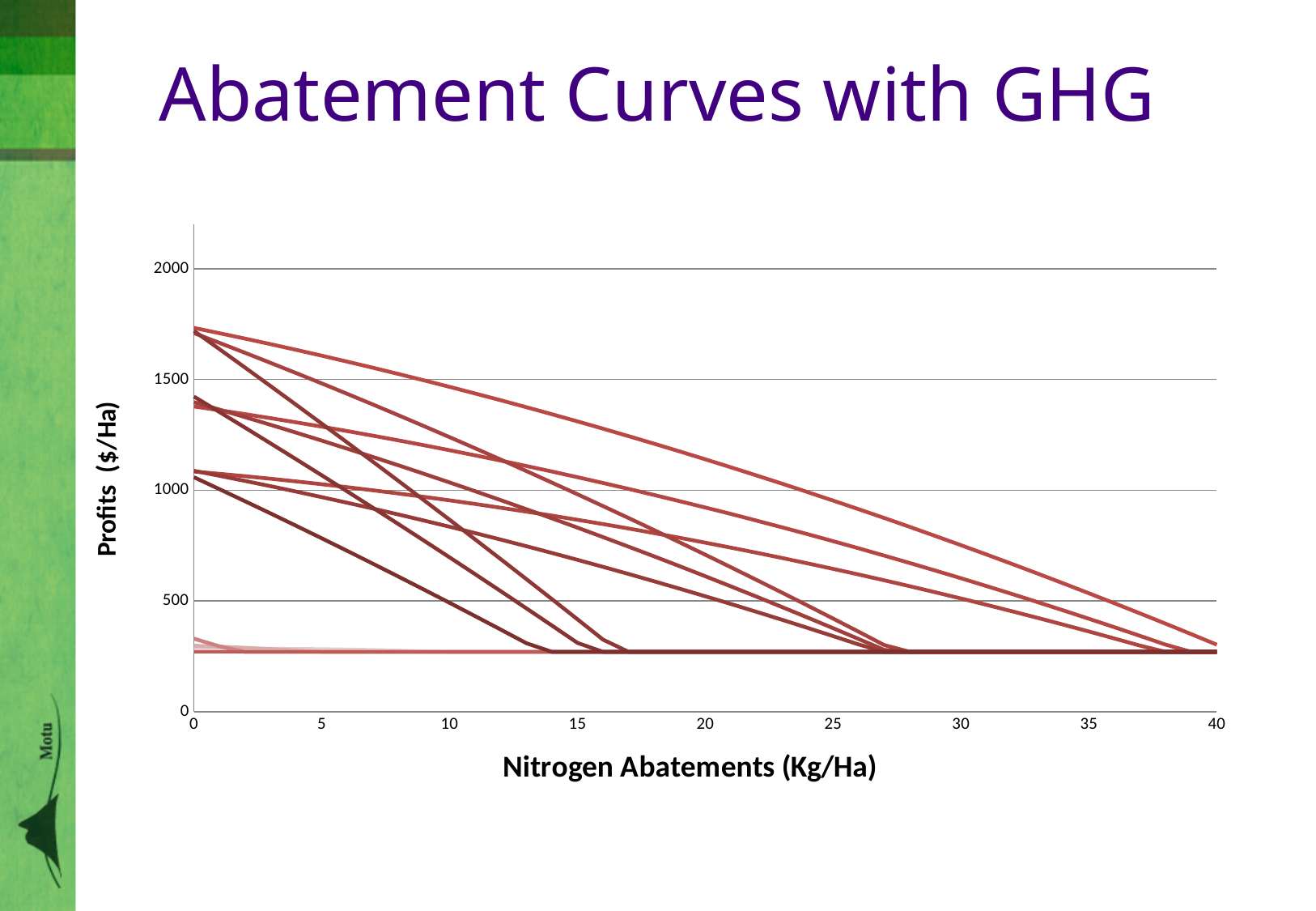
Is the highest profit value at 40 Kg/Ha of nitrogen abatement greater or less than 500? less What kind of chart is shown on the slide? line chart Is the highest profit value at 20 Kg/Ha of nitrogen abatement greater or less than 1500? less What is the maximum value shown on the x axis? 40 What is the maximum value shown on the y axis? 2000 Do the profit curves rise or fall as nitrogen abatement increases along the x axis? fall Is the highest profit value at 10 Kg/Ha of nitrogen abatement greater or less than 1000? greater What is the title of the chart? Abatement Curves with GHG What is the label of the x axis? Nitrogen Abatements (Kg/Ha)